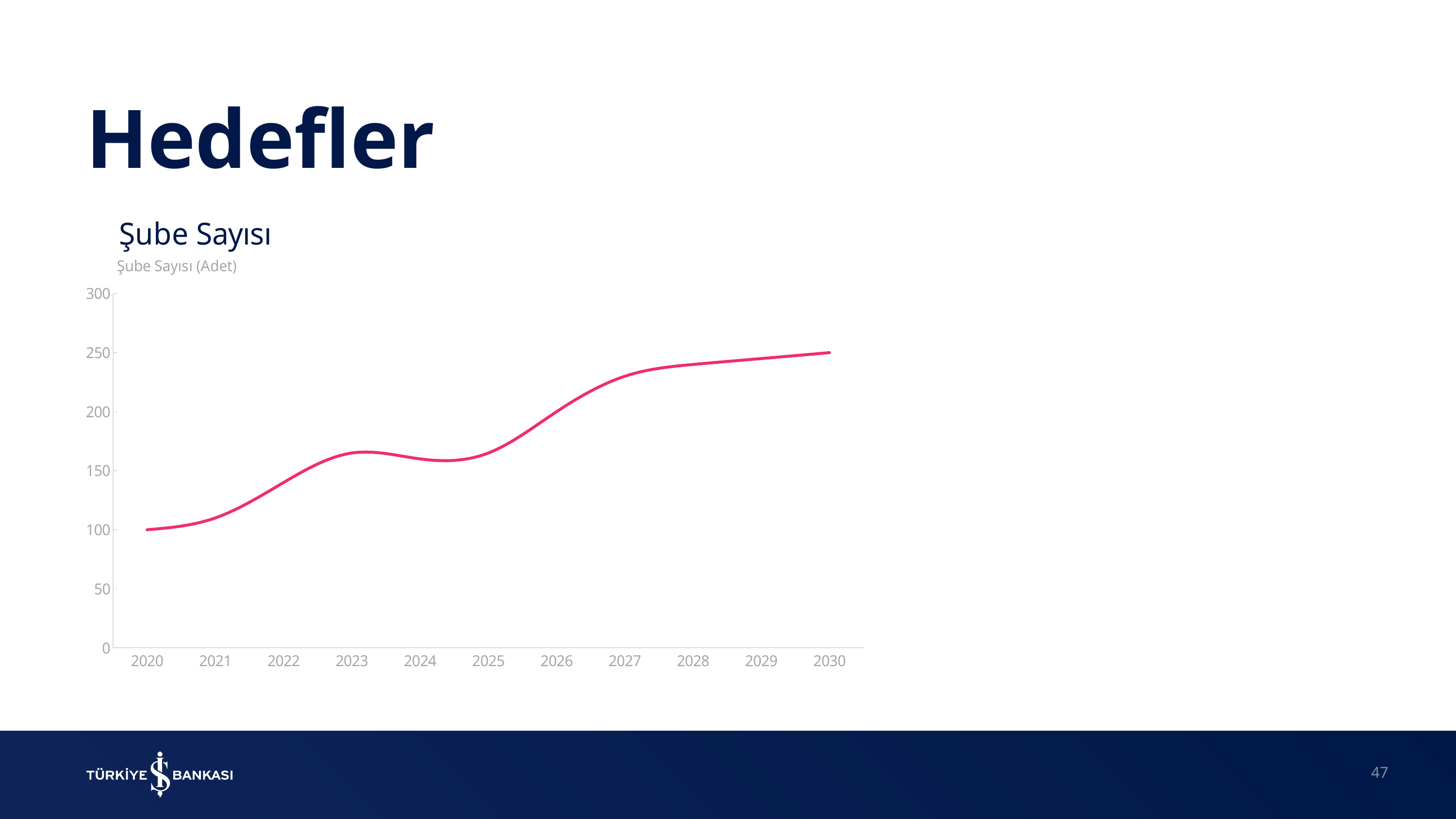
What is the value for 2020? 100 Is the value for 2023 greater or less than 150? greater What is the value for 2030? 250 What is the title of the chart? Şube Sayısı (Adet) Which year has the highest value? 2030 Is the value for 2027 greater or less than 250? less Which is larger, the value for 2022 or the value for 2026? 2026 Which year has the lowest value? 2020 What kind of chart is shown on the slide? line chart Overall, do the values rise or fall from 2020 to 2030? rise How many years are plotted on the x axis? 11